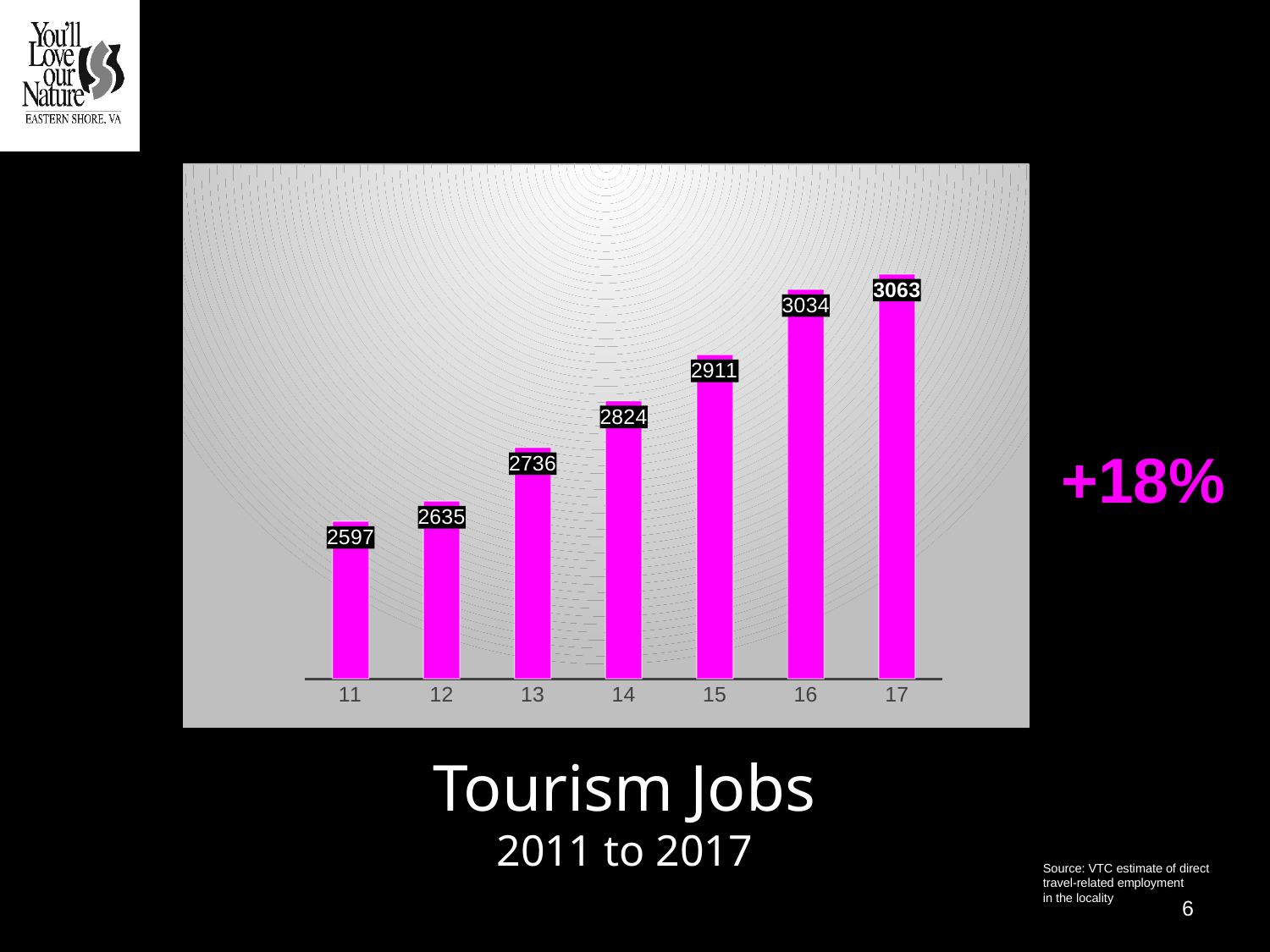
Which year has the lowest value in the Tourism Jobs chart? 11 What kind of chart is shown on the slide? bar chart What is the difference between the values for 16 and 15 in the Tourism Jobs chart? 123 Do the values in the Tourism Jobs chart rise or fall from 11 to 17? rise Which year has the highest value in the Tourism Jobs chart? 17 What percentage change is printed to the right of the chart? +18% What is the value for 17 in the Tourism Jobs chart? 3063 Which is larger in the Tourism Jobs chart, the value for 13 or the value for 15? 15 How many bars are shown in the Tourism Jobs chart? 7 What is the difference between the values for 17 and 11 in the Tourism Jobs chart? 466 What is the value for 14 in the Tourism Jobs chart? 2824 What is the value for 11 in the Tourism Jobs chart? 2597